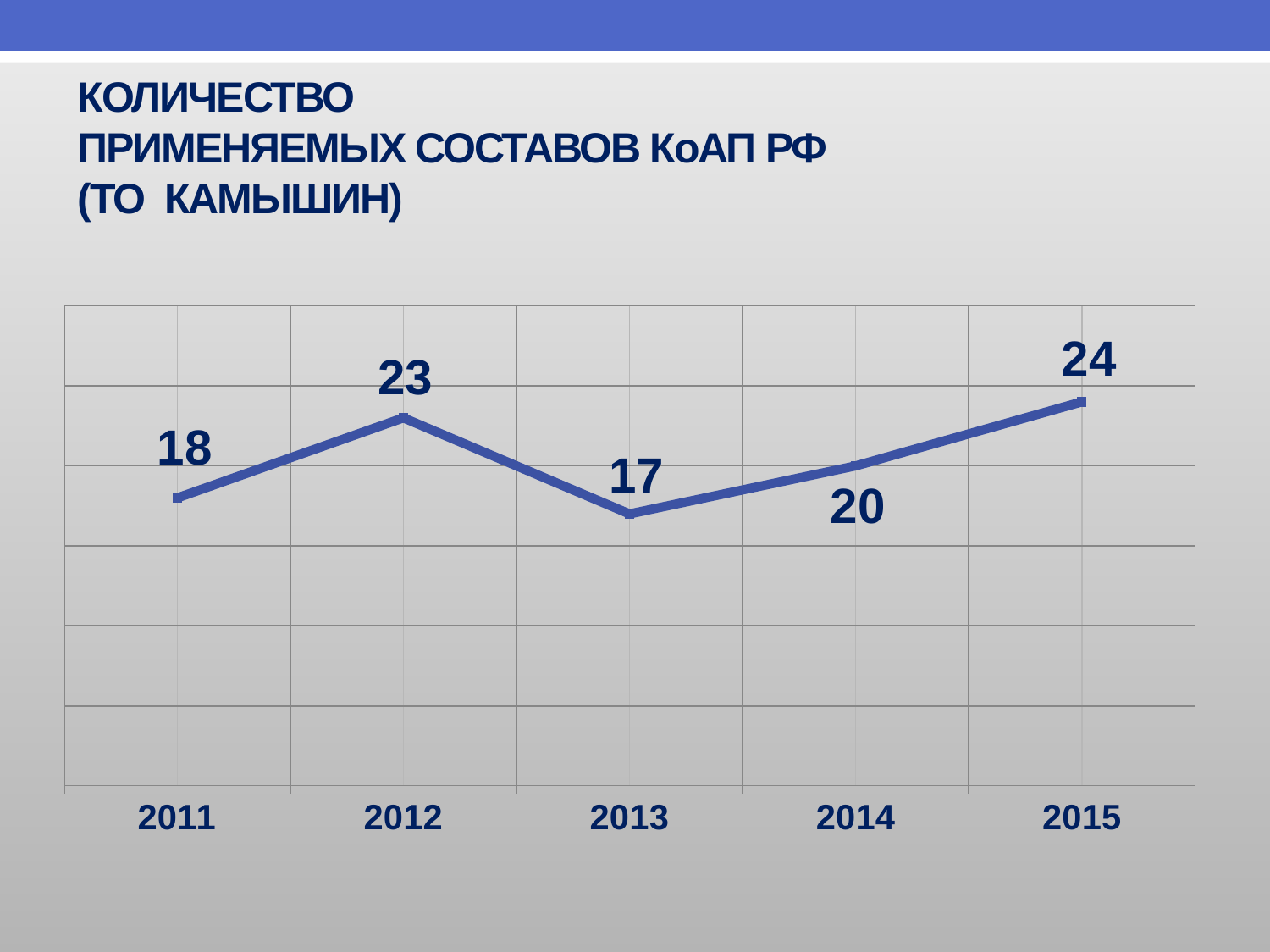
What is the value for 2013? 17 What is the title of the chart? КОЛИЧЕСТВО ПРИМЕНЯЕМЫХ СОСТАВОВ КоАП РФ (ТО КАМЫШИН) What is the difference between the values for 2012 and 2013? 6 What is the difference between the values for 2015 and 2011? 6 Which year has the highest value? 2015 What is the value for 2015? 24 Which is larger, the value for 2012 or the value for 2014? 2012 What kind of chart is shown on the slide? line chart Which year has the lowest value? 2013 What is the value for 2011? 18 Does the value rise or fall from 2013 to 2015? rise How many years are plotted on the chart? 5